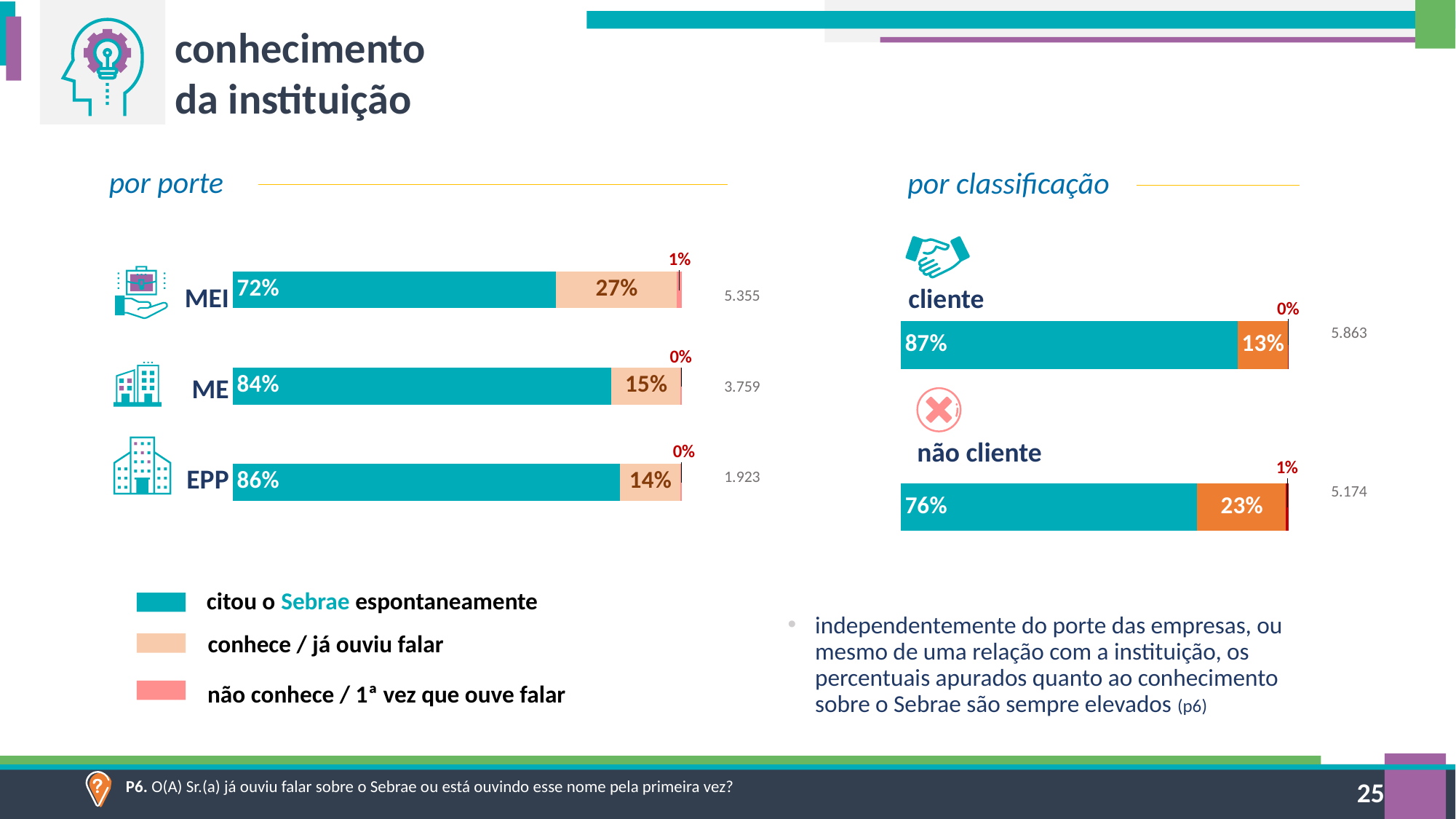
How many series does the legend list for the charts? 3 In the 'por porte' chart, what is the 'conhece / já ouviu falar' value for ME? 15% In the 'por classificação' chart, what is the 'conhece / já ouviu falar' value for 'cliente'? 13% In the 'por porte' chart, which category has the lowest 'citou o Sebrae espontaneamente' percentage? MEI In the 'por porte' chart, which category has the highest 'citou o Sebrae espontaneamente' percentage? EPP In the 'por classificação' chart, what percentage of 'não cliente' respondents cited Sebrae spontaneously? 76% In the 'por porte' chart, what is the difference between the 'conhece / já ouviu falar' values for MEI and EPP? 13 percentage points What type of chart is the 'por porte' chart? Stacked bar chart In the 'por classificação' chart, which group has the larger 'citou o Sebrae espontaneamente' share, cliente or não cliente? cliente In the 'por classificação' chart, what is the difference between the 'citou o Sebrae espontaneamente' values for cliente and não cliente? 11 percentage points In the 'por porte' chart, what percentage of MEI respondents cited Sebrae spontaneously ('citou o Sebrae espontaneamente')? 72% How many categories are shown in the 'por porte' chart? 3